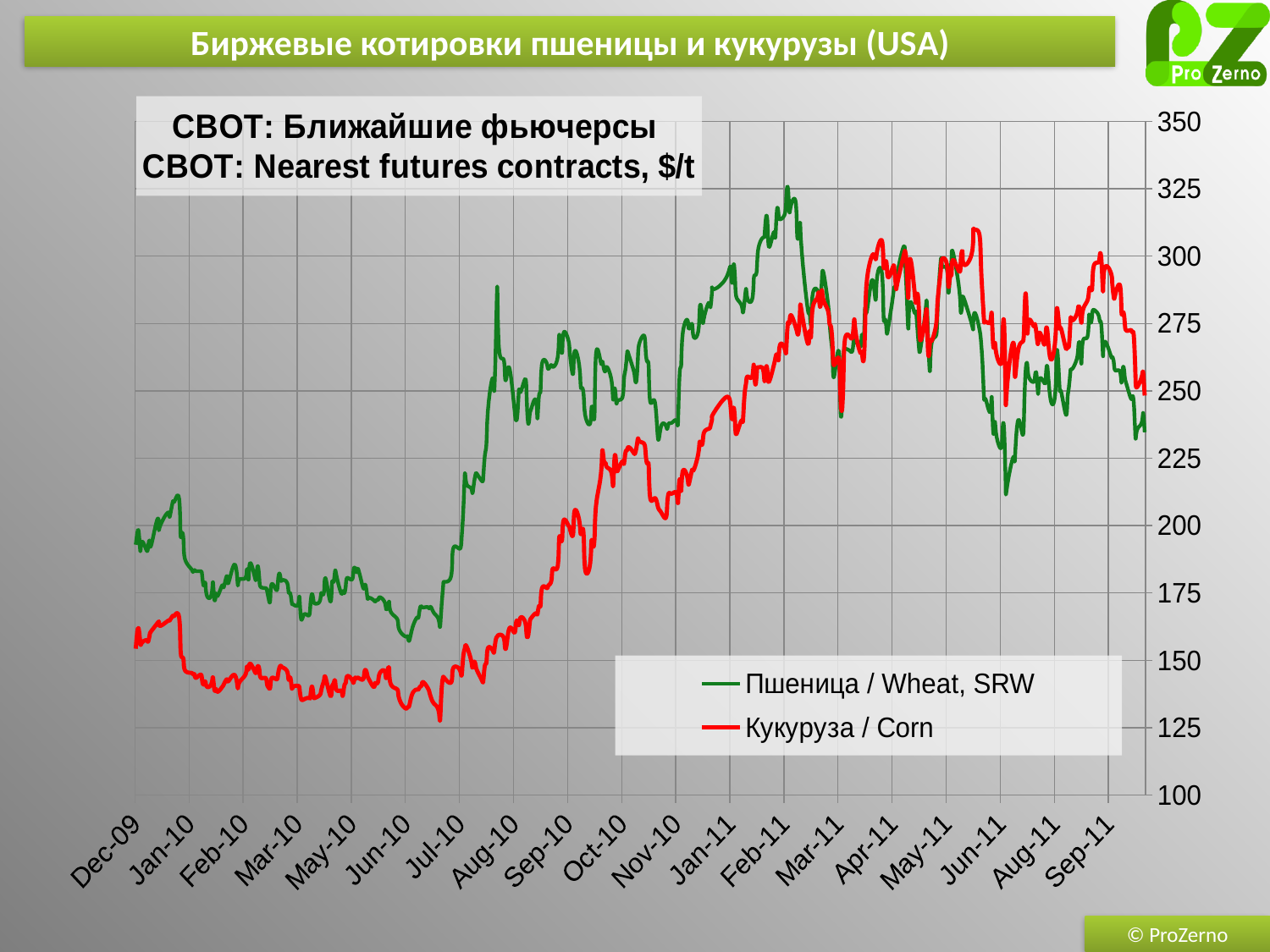
Does the Corn series rise or fall between Jun-10 and Feb-11? rise Is the value for Corn in Jun-10 greater or less than 150? less How many month labels are shown on the x axis? 19 Is the value for Wheat, SRW in Jun-10 greater or less than 175? less What kind of chart is shown on the slide? line chart Which series is higher in Jun-10, Wheat, SRW or Corn? Wheat, SRW Is the value for Corn in Mar-10 greater or less than 175? less Which series is drawn in red? Кукуруза / Corn What unit is given in the chart title for the futures prices? $/t Which series is higher in Jun-11, Wheat, SRW or Corn? Corn How many series does the legend list? 2